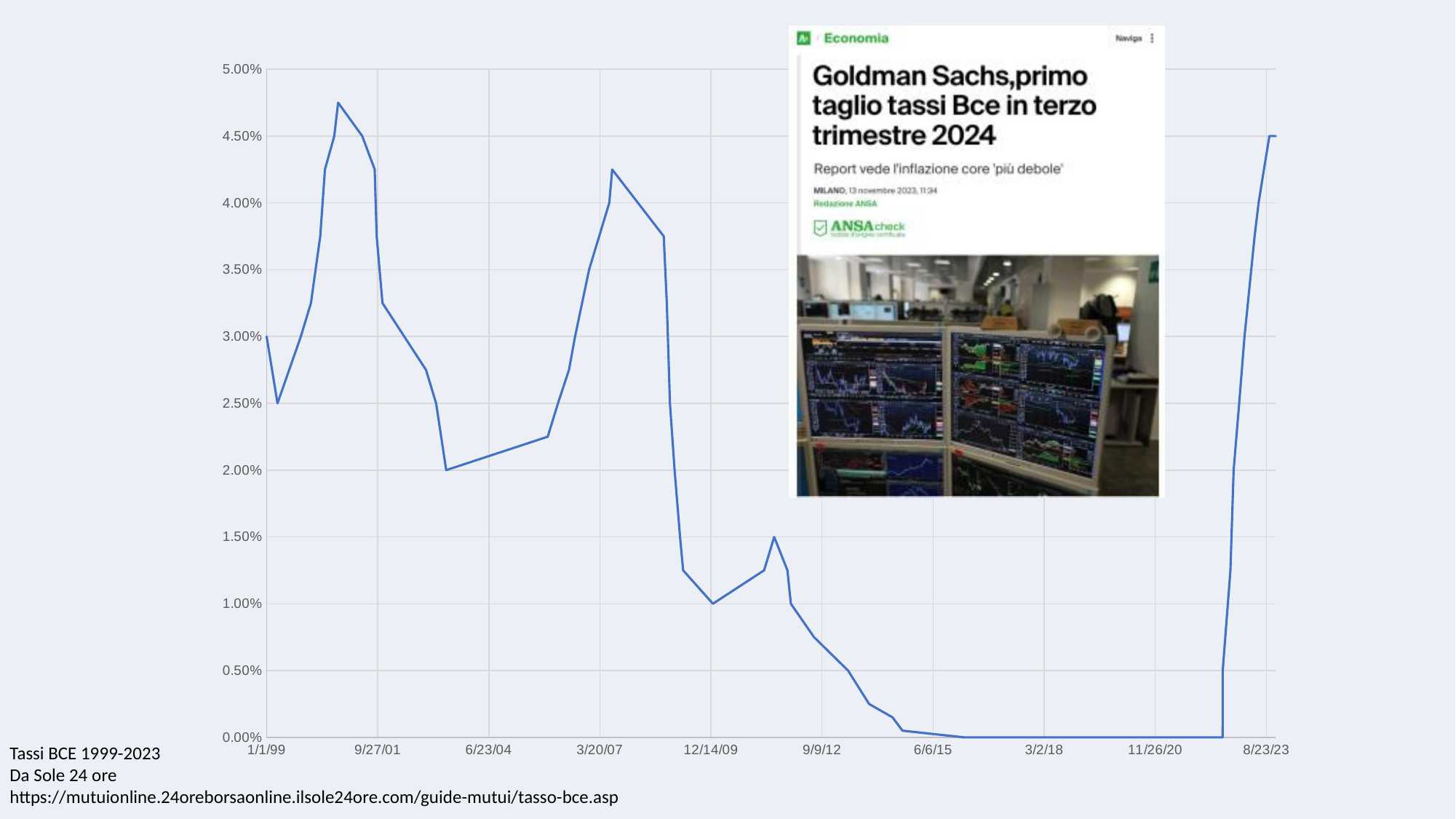
What is the source of the chart data given on the slide? Sole 24 ore What is the title of the chart on the slide? Tassi BCE 1999-2023 Is the value at 3/20/07 greater or less than 3.50%? greater What is the value of the line at 8/23/23? 4.50% Does the line rise or fall between 11/26/20 and 8/23/23? rise What is the value of the line at 1/1/99? 3.00% What is the value of the line at 3/2/18? 0.00% What is the value of the line at 12/14/09? 1.00% What kind of chart is shown on the slide? line chart Which is larger, the value at 1/1/99 or the value at 8/23/23? 8/23/23 Is the value at 9/9/12 greater or less than 1.00%? less Is the value at 9/27/01 greater or less than 3.00%? greater